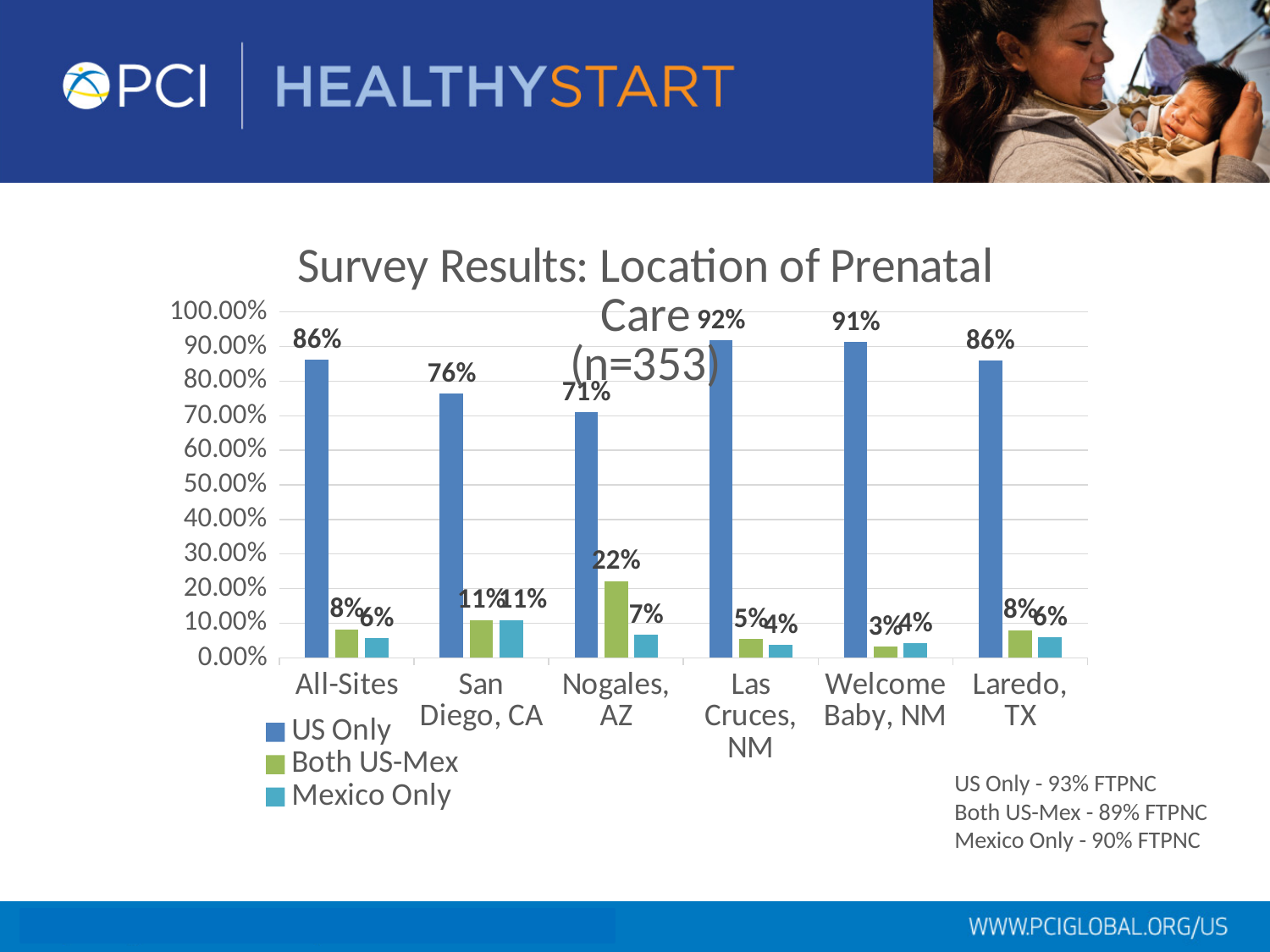
What is the Mexico Only value for San Diego, CA? 11% Which site has the lowest US Only value? Nogales, AZ What is the US Only value for Welcome Baby, NM? 91% What is the Both US-Mex value for Nogales, AZ? 22% What is the difference between the Both US-Mex value and the Mexico Only value for Nogales, AZ? 15 percentage points Which site has the highest US Only value? Las Cruces, NM What is the US Only value for Nogales, AZ? 71% How many sites (categories) are shown on the x axis? 6 Is the US Only value for San Diego, CA greater or less than 80.00%? less Which is larger for Las Cruces, NM: the Both US-Mex value or the Mexico Only value? Both US-Mex What kind of chart is shown on the slide? Bar chart How many series does the legend list? 3